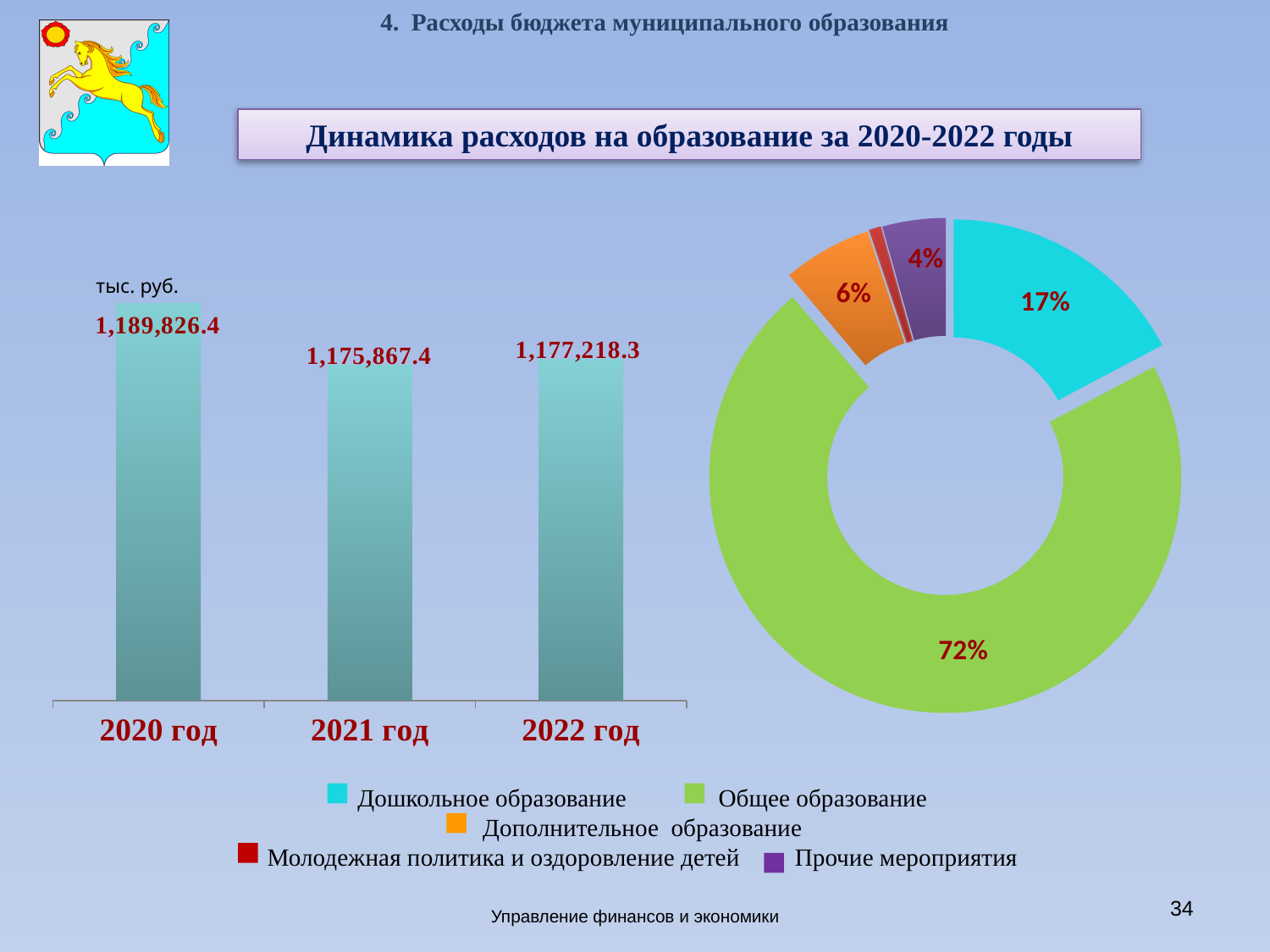
In the bar chart on the left, which year has the highest value? 2020 год In the bar chart on the left, what is the value for 2022 год? 1,177,218.3 In the bar chart on the left, how many years are shown? 3 How many categories does the legend of the pie chart on the right list? 5 In the bar chart on the left, what is the value for 2020 год? 1,189,826.4 In the pie chart on the right, what share does Общее образование have? 72% In the bar chart on the left, which is larger: the value for 2021 год or 2022 год? 2022 год In the pie chart on the right, which category has the largest share? Общее образование In the bar chart on the left, which year has the lowest value? 2021 год What kind of chart is on the left side of the slide? Bar chart In the bar chart on the left, what is the difference between the values for 2020 год and 2021 год? 13,959.0 In the bar chart on the left, what is the value for 2021 год? 1,175,867.4